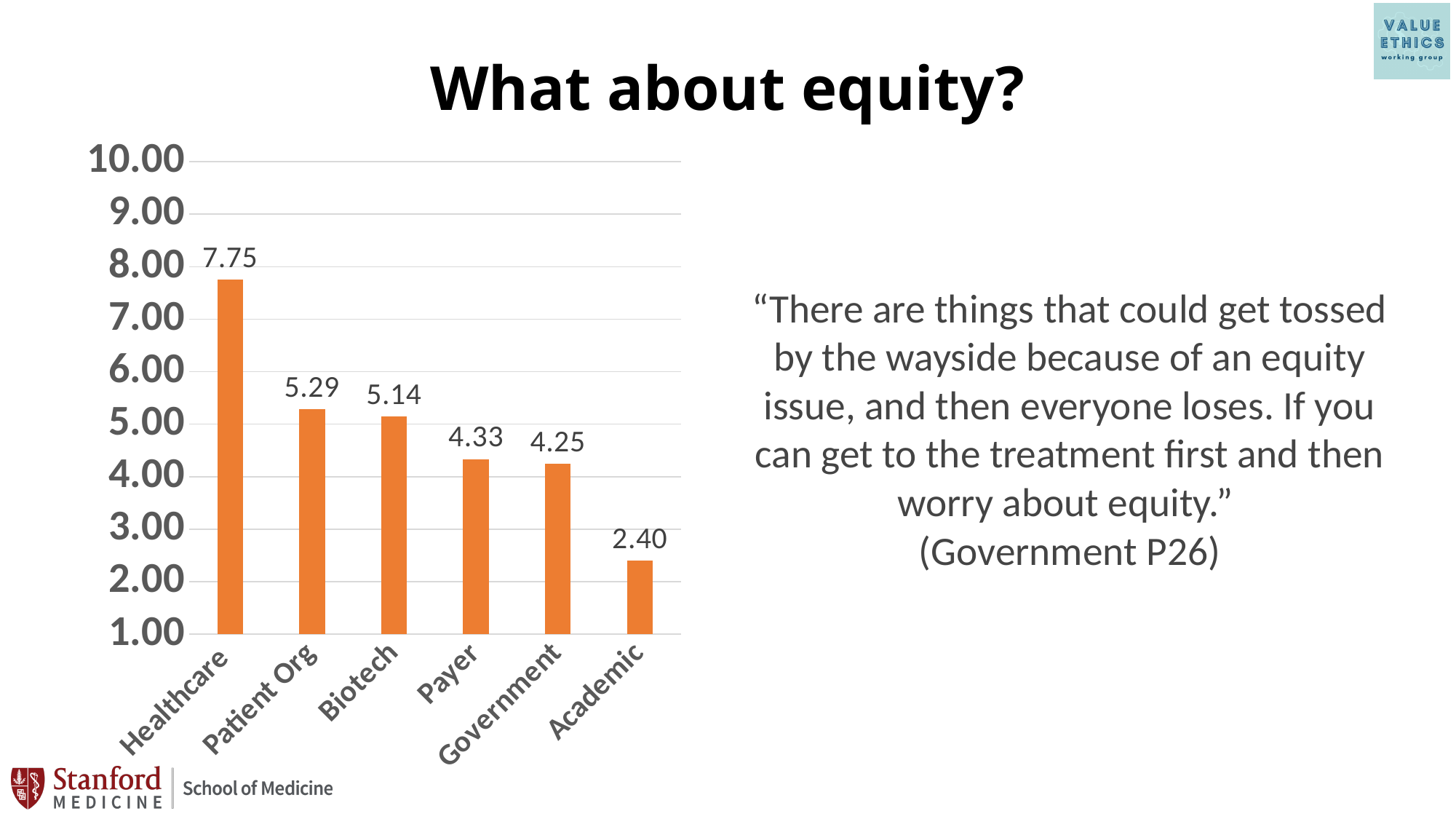
What kind of chart is shown on the slide? Bar chart What is the difference between the values for Healthcare and Academic? 5.35 Which category has the highest value? Healthcare Which category has the lowest value? Academic What is the value for Biotech? 5.14 What is the value for Healthcare? 7.75 What is the value for Patient Org? 5.29 What is the value for Academic? 2.40 Do the values rise or fall from left to right along the x axis? Fall Which is larger, the value for Patient Org or the value for Payer? Patient Org What is the difference between the values for Payer and Government? 0.08 How many categories are shown on the x axis? 6